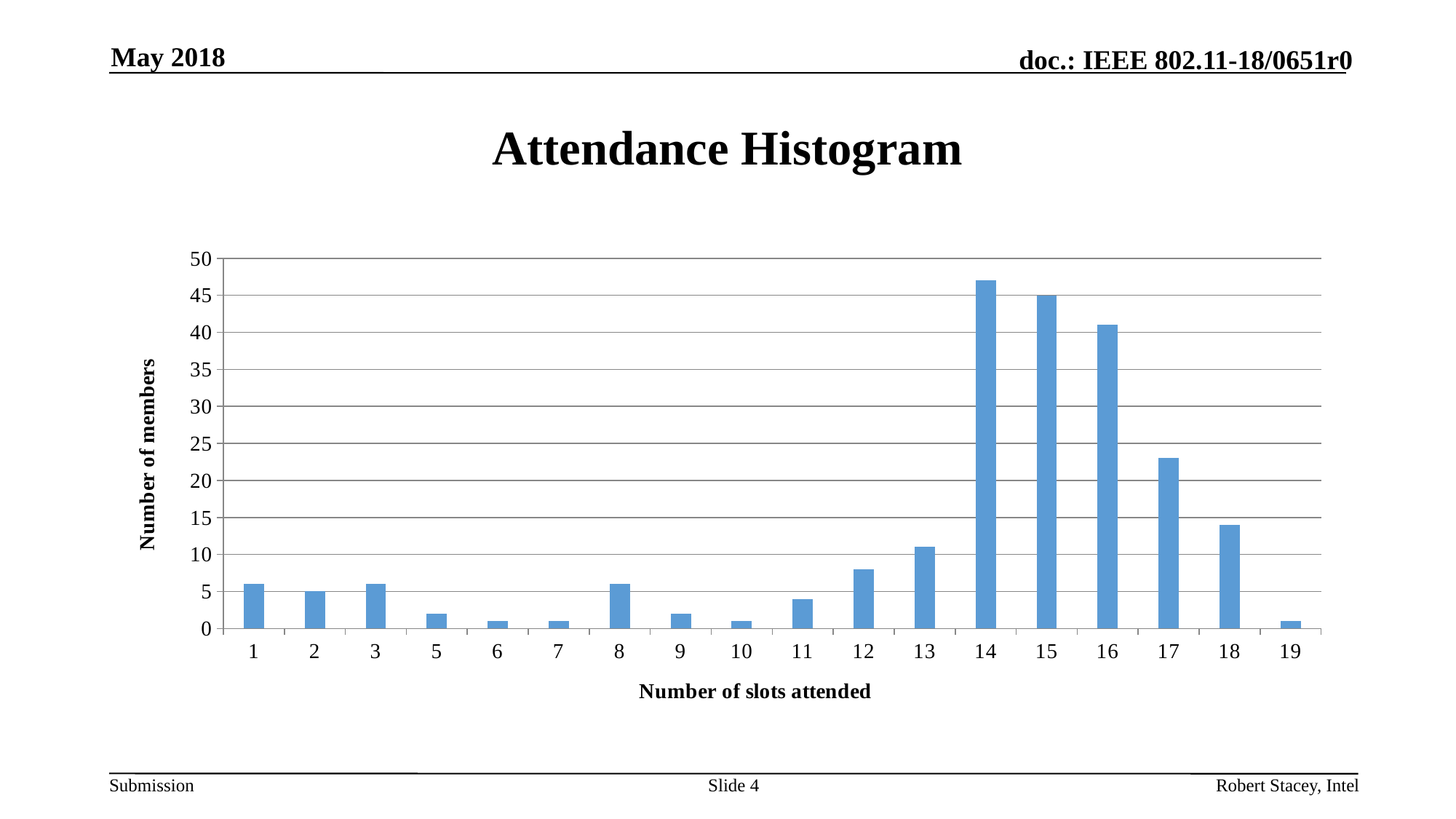
What is the label of the vertical axis? Number of members Which has more members: 15 slots attended or 16 slots attended? 15 Is the number of members for 12 slots attended greater or less than 10? less What is the number of members for 2 slots attended? 5 Is the number of members for 17 slots attended greater or less than 25? less How many categories (numbers of slots attended) are shown on the x axis? 18 Is the number of members for 14 slots attended greater or less than 45? greater What type of chart is shown on the slide? bar chart What is the title of the chart? Attendance Histogram Which number of slots attended has the highest number of members? 14 Which has more members: 17 slots attended or 18 slots attended? 17